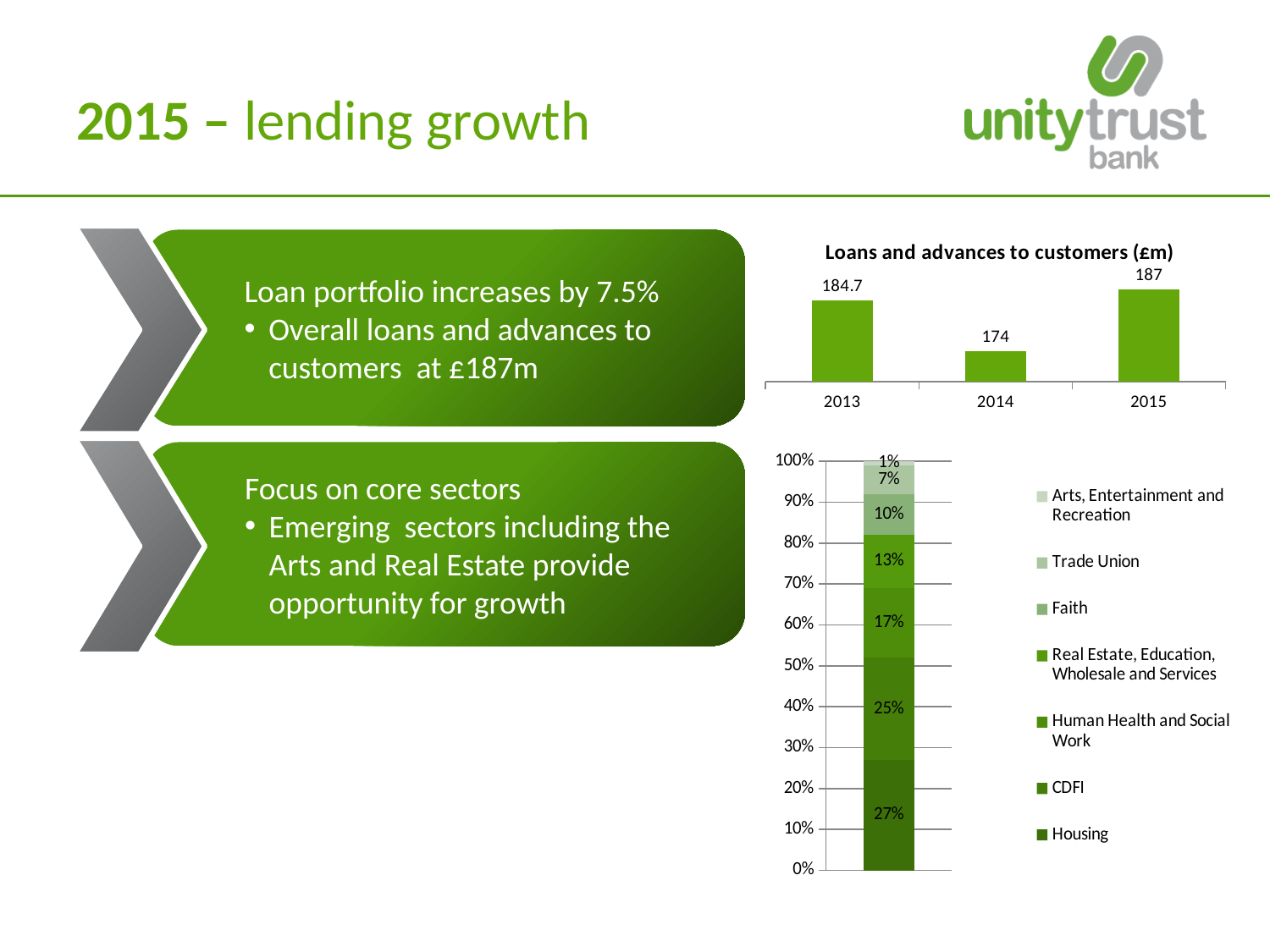
In the stacked bar chart at the bottom right, what percentage is shown for CDFI? 25% In the stacked bar chart at the bottom right, what percentage is shown for Housing? 27% In the 'Loans and advances to customers (£m)' chart, which year has the lowest value? 2014 In the 'Loans and advances to customers (£m)' chart, what is the difference between the 2015 and 2014 values? 13 In the stacked bar chart at the bottom right, which sector has the smallest share? Arts, Entertainment and Recreation What kind of chart is the 'Loans and advances to customers (£m)' chart? bar chart In the 'Loans and advances to customers (£m)' chart, what is the value for 2015? 187 In the 'Loans and advances to customers (£m)' chart, how many years are shown? 3 How many series does the legend of the stacked bar chart at the bottom right list? 7 In the 'Loans and advances to customers (£m)' chart, what is the value for 2013? 184.7 In the stacked bar chart at the bottom right, which is larger: the share for Faith or the share for Trade Union? Faith In the 'Loans and advances to customers (£m)' chart, which year has the highest value? 2015